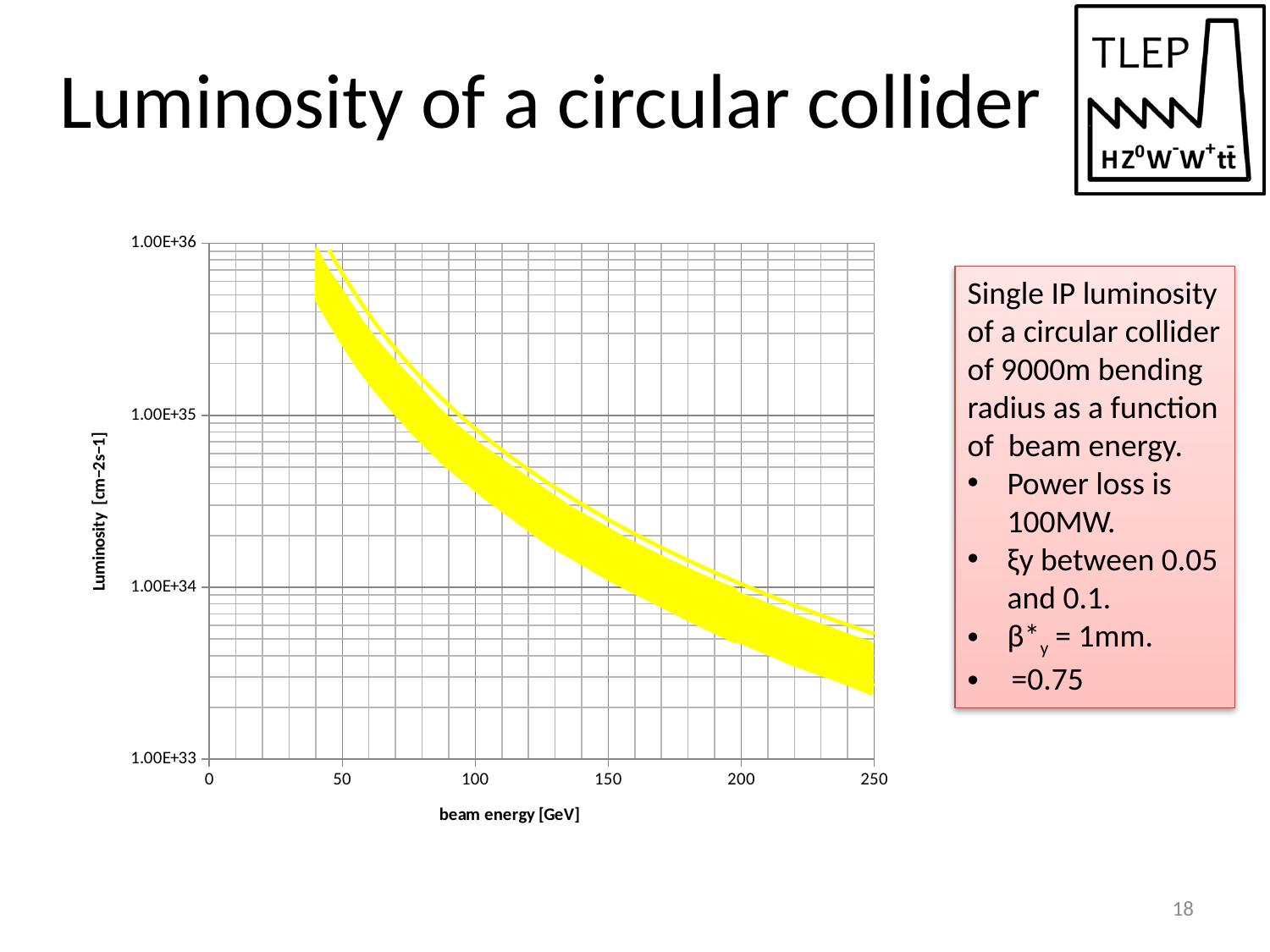
Is the luminosity higher at a beam energy of 50 GeV or at 250 GeV? 50 GeV What is the label of the x axis of the chart? beam energy [GeV] How many tick labels are shown on the x axis of the chart? 6 Is the luminosity at a beam energy of 50 GeV greater or less than 1.00E+35? greater What kind of chart is shown on the slide? line chart Is the luminosity at a beam energy of 250 GeV greater or less than 1.00E+33? greater Does the luminosity rise or fall as beam energy increases along the x axis? fall Is the luminosity at a beam energy of 250 GeV greater or less than 1.00E+34? less What is the highest value shown on the y axis of the chart? 1.00E+36